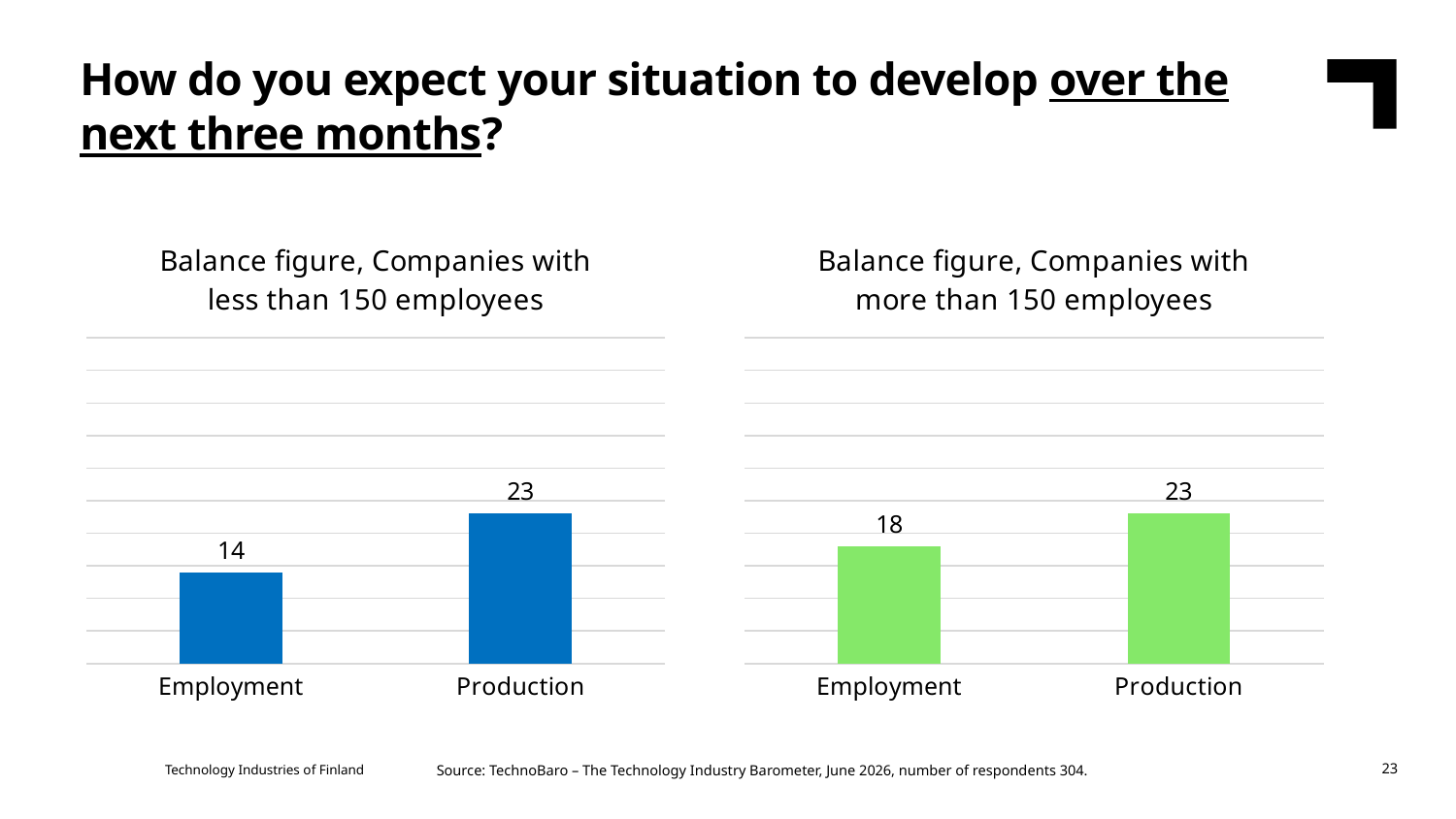
In the chart titled 'Balance figure, Companies with less than 150 employees', what is the difference between the Production and Employment values? 9 What type of chart is used for 'Balance figure, Companies with more than 150 employees'? Bar chart In the chart titled 'Balance figure, Companies with more than 150 employees', what is the difference between the Production and Employment values? 5 In the chart titled 'Balance figure, Companies with less than 150 employees', what is the value for Employment? 14 What colour are the bars in the right chart (companies with more than 150 employees)? Green In the chart titled 'Balance figure, Companies with more than 150 employees', what is the value for Employment? 18 In the left chart (companies with less than 150 employees), which category has the highest value? Production Comparing the Employment values across the two charts, which chart shows the larger Employment value? Balance figure, Companies with more than 150 employees In the chart titled 'Balance figure, Companies with more than 150 employees', what is the value for Production? 23 In the right chart (companies with more than 150 employees), which category has the lowest value? Employment In the chart titled 'Balance figure, Companies with less than 150 employees', what is the value for Production? 23 How many categories are shown in the left chart (companies with less than 150 employees)? 2